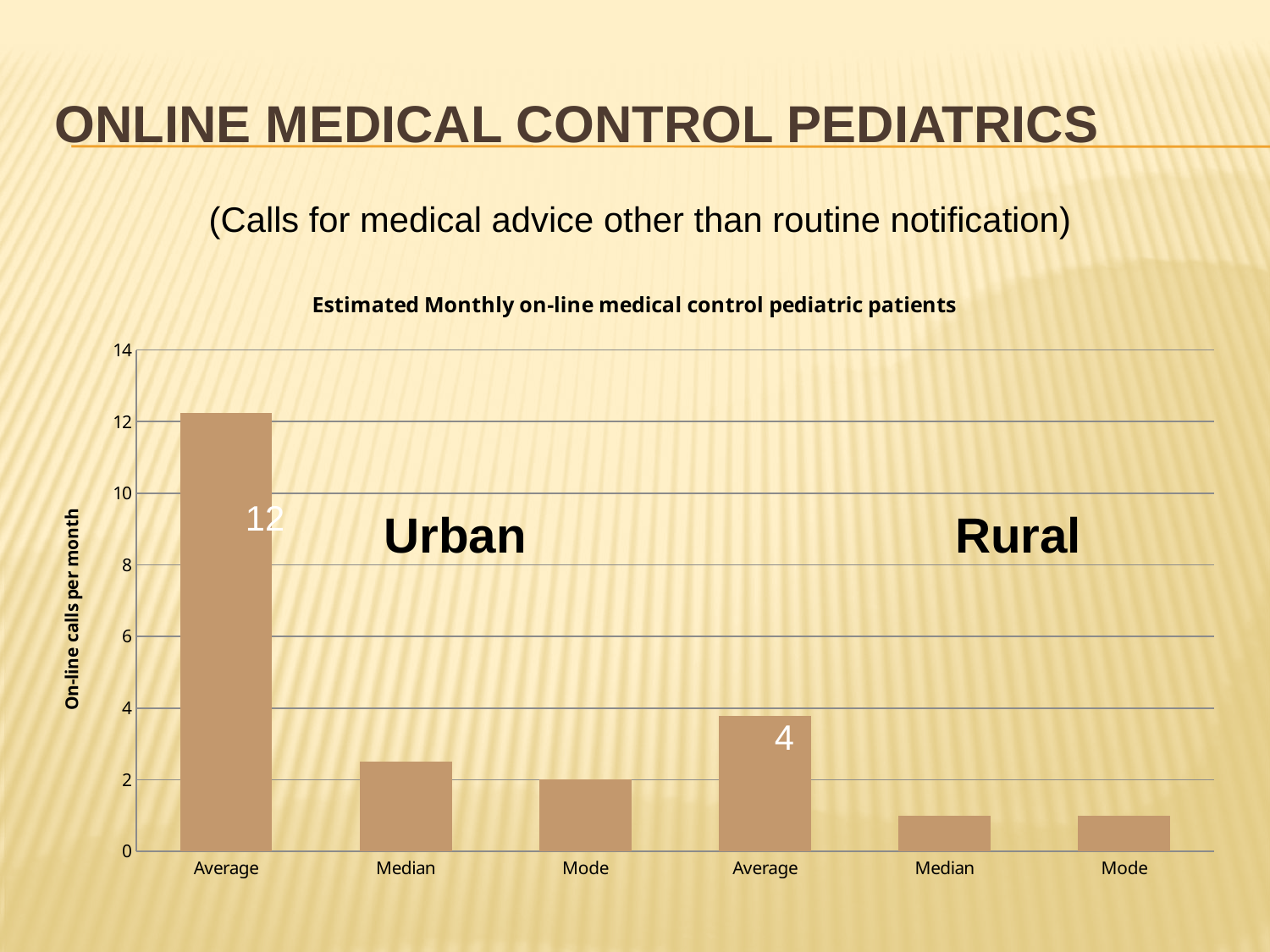
What kind of chart is shown on the slide? bar chart What is the difference between the Urban Average and the Rural Average values? 8 Which bar is the highest in the chart? Urban Average What is the value of the Rural Average bar? 4 What is the value of the Urban Average bar? 12 How many bars are plotted in the chart? 6 Is the value for the Urban Average greater or less than 10? greater What is the label on the vertical axis of the chart? On-line calls per month What is the title of the chart? Estimated Monthly on-line medical control pediatric patients Is the value for the Rural Median greater or less than 2? less Is the value for the Urban Median greater or less than 4? less Which is larger, the Urban Average or the Rural Average? Urban Average